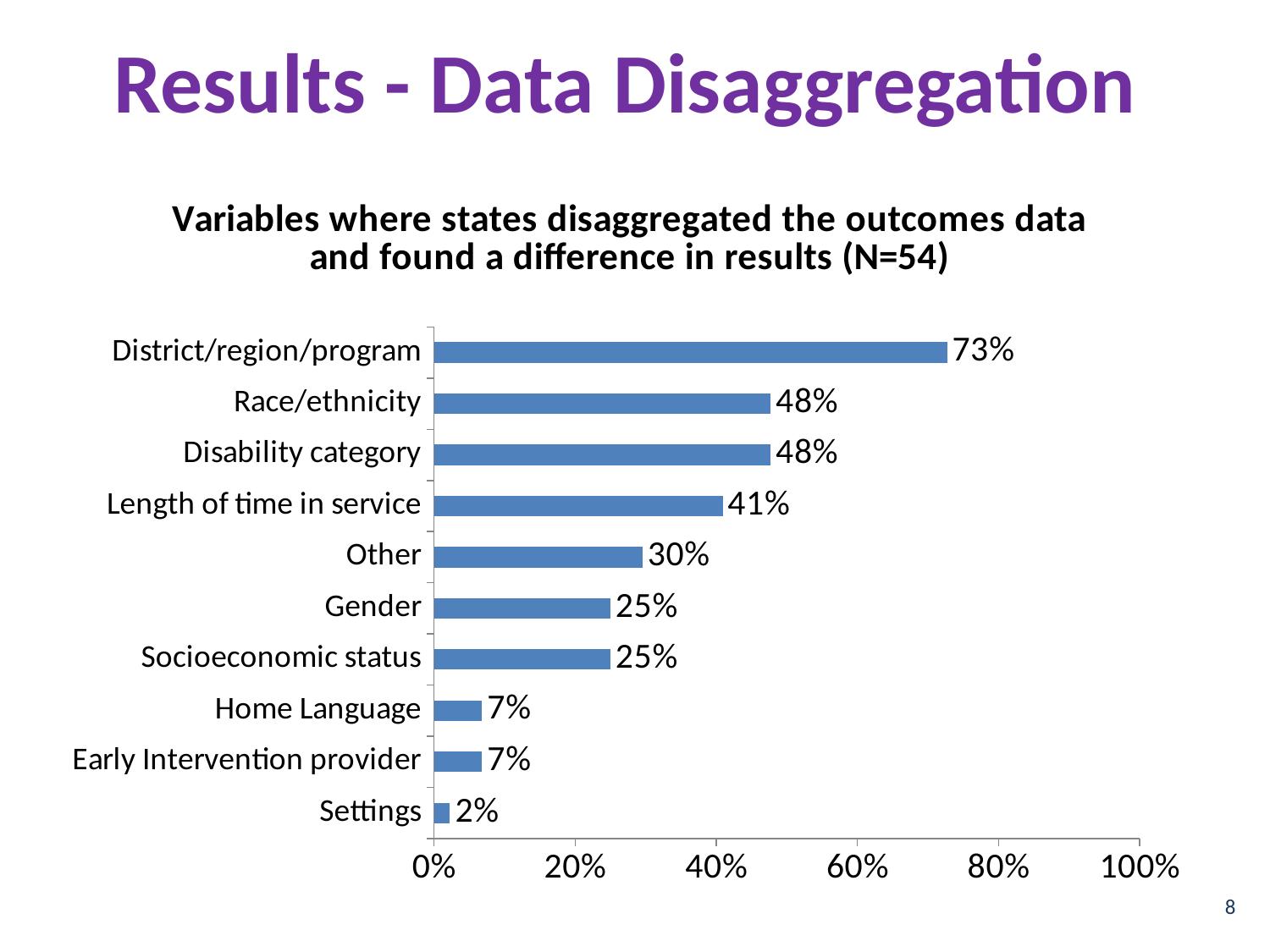
What is the N stated in the chart title? 54 What is the difference between the values for District/region/program and Race/ethnicity? 25% Which category has the lowest value? Settings Is the value for Disability category greater or less than 40%? greater What is the value for Gender? 25% What is the value for Length of time in service? 41% How many categories are shown in the chart? 10 What kind of chart is shown on the slide? bar chart What is the difference between the values for Other and Home Language? 23% What is the value for District/region/program? 73% Which is larger, the value for Length of time in service or the value for Other? Length of time in service Which category has the highest value? District/region/program